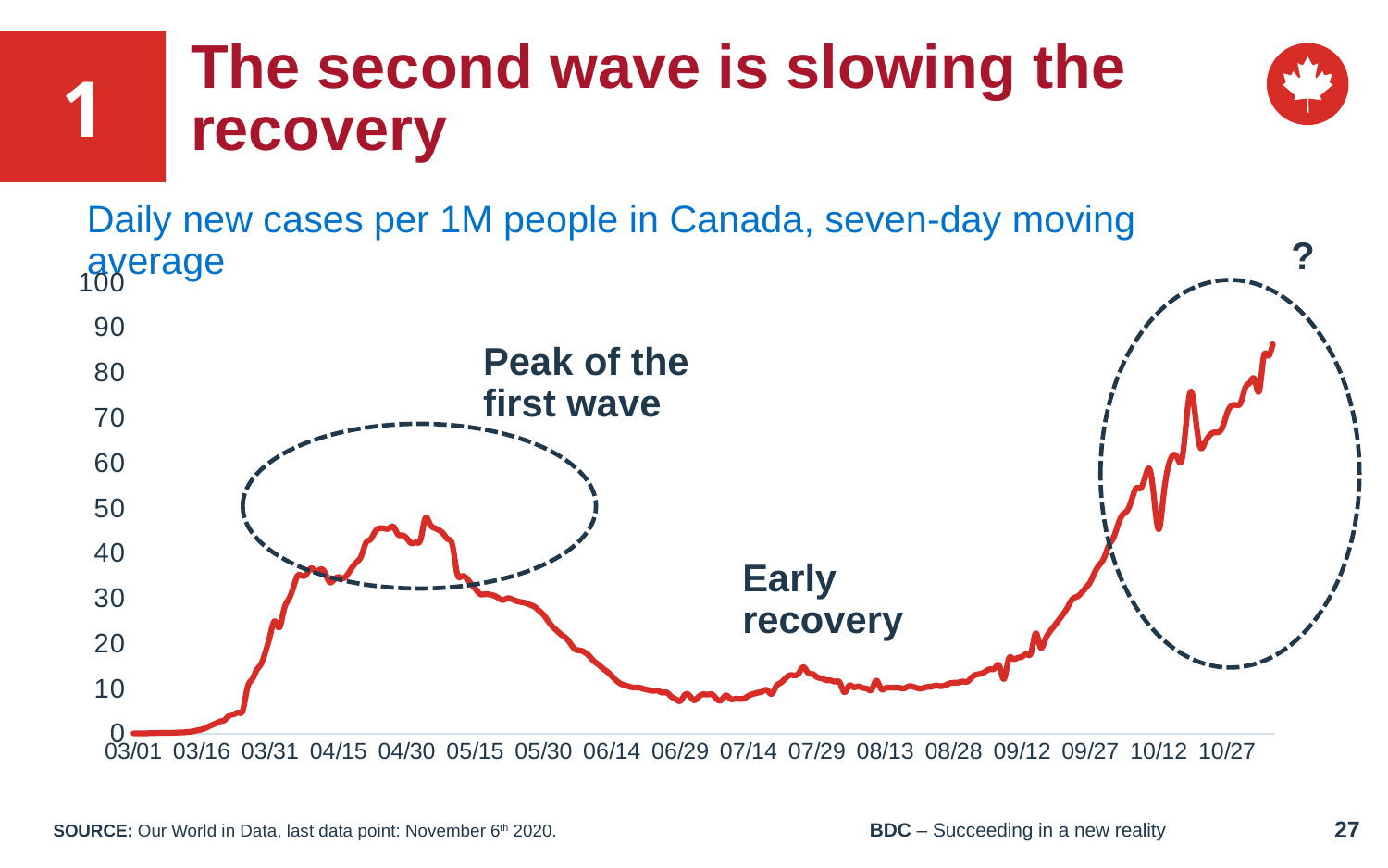
Is the value around 08/13 greater or less than 20? less What kind of chart is shown on the slide? Line chart What is the title of the chart? Daily new cases per 1M people in Canada, seven-day moving average Is the value around 06/29 greater or less than 20? less Is the last plotted value (early November) greater or less than 80? greater Does the line rise or fall between 05/15 and 06/29? Falls How many date labels are shown on the x axis? 17 What label is attached to the dashed circle around the spring 2020 portion of the line? Peak of the first wave Does the line rise or fall between 09/27 and the end of the series? Rises Which is higher: the peak of the first wave (around 04/30) or the last plotted value in the second wave? The last plotted value in the second wave